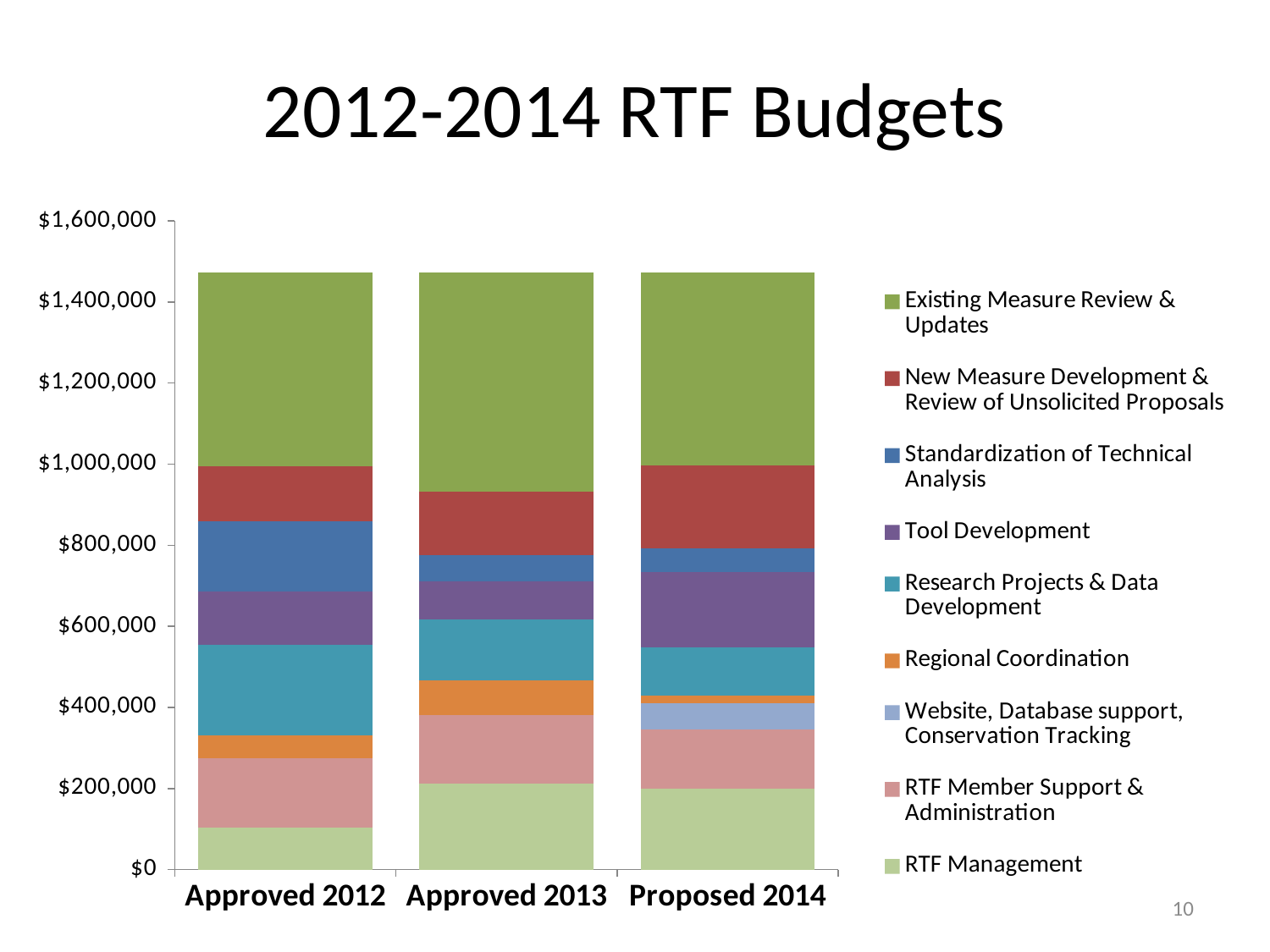
Is the total budget for Proposed 2014 greater or less than $1,600,000? less Which year has the larger RTF Management segment, Approved 2012 or Approved 2013? Approved 2013 How many series does the legend list? 9 Which series forms the bottom segment of each stacked bar? RTF Management What is the title of the slide's chart? 2012-2014 RTF Budgets Which year has the larger Tool Development segment, Approved 2013 or Proposed 2014? Proposed 2014 Is the total budget for Approved 2012 greater or less than $1,400,000? greater Which year has the larger Standardization of Technical Analysis segment, Approved 2012 or Approved 2013? Approved 2012 Is the value for Existing Measure Review & Updates in Approved 2013 greater or less than $400,000? greater What kind of chart is shown on the slide? Stacked bar chart How many budget years (categories) are shown on the x axis? 3